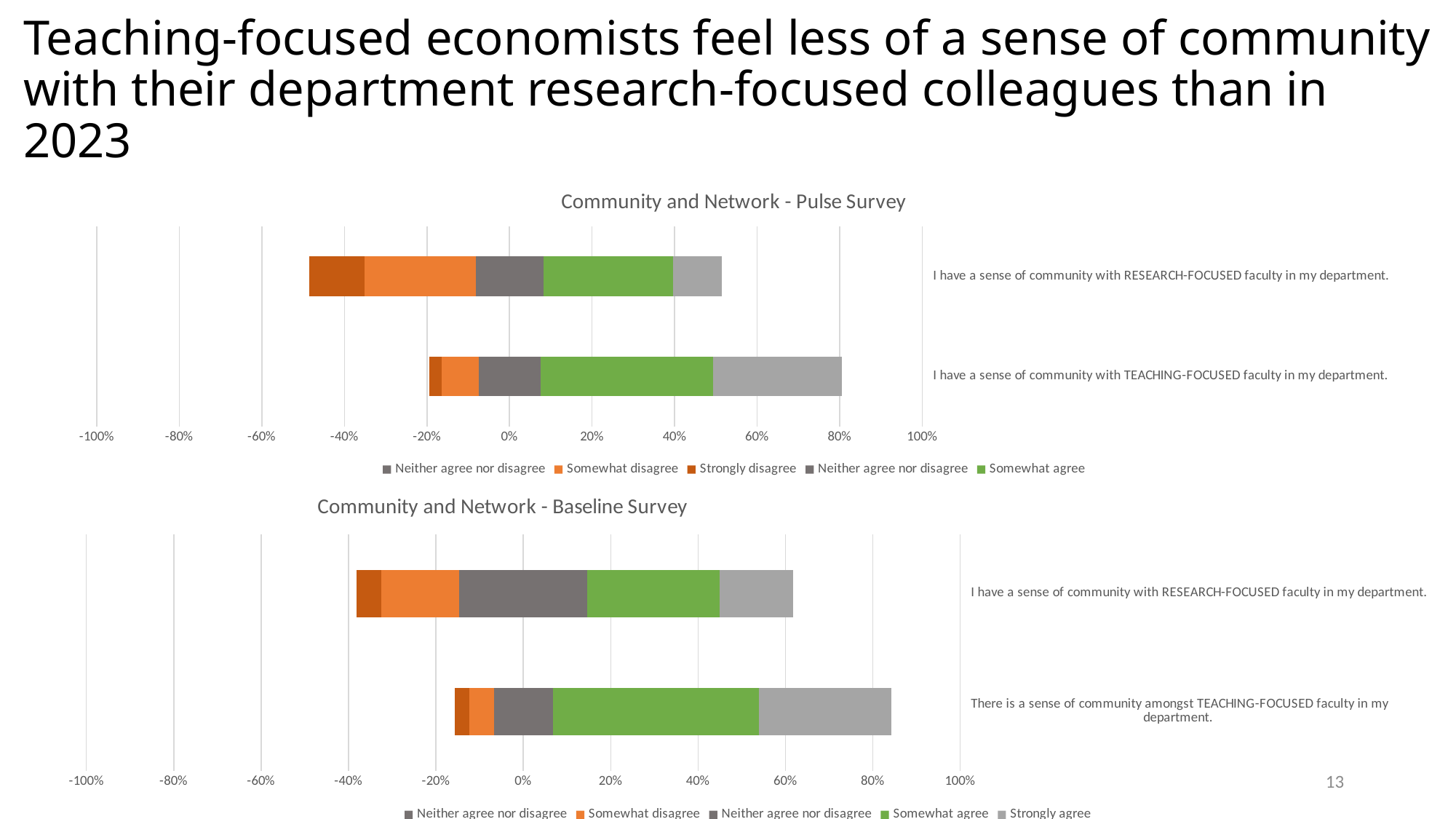
What is the title of the upper chart on the slide? Community and Network - Pulse Survey How many statements (bars) are plotted in the "Community and Network - Baseline Survey" chart? 2 What kind of chart is the "Community and Network - Baseline Survey" chart? Stacked bar chart How many entries does the legend of the "Community and Network - Pulse Survey" chart list? 5 In the "Community and Network - Pulse Survey" chart, is the right-hand end of the bar for "I have a sense of community with RESEARCH-FOCUSED faculty in my department" greater or less than 60%? less In the "Community and Network - Pulse Survey" chart, which statement's bar extends further to the right (more agreement): the RESEARCH-FOCUSED statement or the TEACHING-FOCUSED statement? The TEACHING-FOCUSED statement In the "Community and Network - Baseline Survey" chart, which statement's bar extends further to the left (more disagreement): the RESEARCH-FOCUSED statement or the TEACHING-FOCUSED statement? The RESEARCH-FOCUSED statement How many statements (bars) are plotted in the "Community and Network - Pulse Survey" chart? 2 In the "Community and Network - Pulse Survey" chart, is the right-hand end of the bar for "I have a sense of community with TEACHING-FOCUSED faculty in my department" greater or less than 60%? greater What kind of chart is the "Community and Network - Pulse Survey" chart? Stacked bar chart How many entries does the legend of the "Community and Network - Baseline Survey" chart list? 5 In the "Community and Network - Baseline Survey" chart, is the left-hand end of the bar for "I have a sense of community with RESEARCH-FOCUSED faculty in my department" greater or less than -20%? less